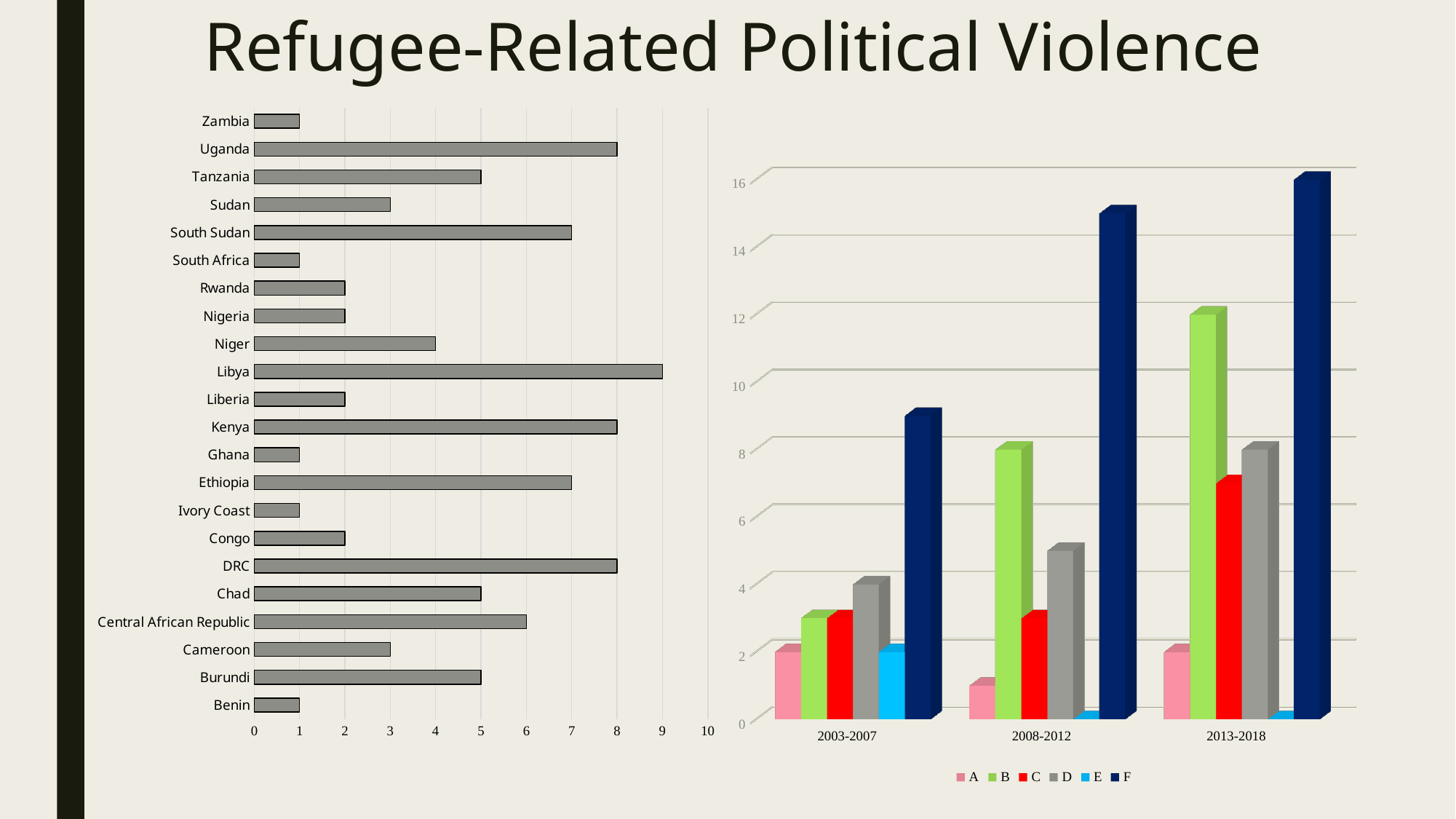
On the left chart, what is the difference between the values for Uganda and Sudan? 5 On the left chart, which has the larger value, Tanzania or Niger? Tanzania On the right chart, is the value for series A in 2013-2018 greater or less than 4? less On the right chart, how many time periods are shown on the x axis? 3 On the left chart, which country has the highest value? Libya On the right chart, how many series does the legend list? 6 What kind of chart is the left chart? Bar chart On the right chart, does the value for series B rise or fall from 2003-2007 to 2013-2018? Rise On the right chart, is the value for series F in 2008-2012 greater or less than 12? greater On the left chart, what is the value for Libya? 9 On the left chart, how many countries are listed? 22 On the left chart, what is the value for Central African Republic? 6